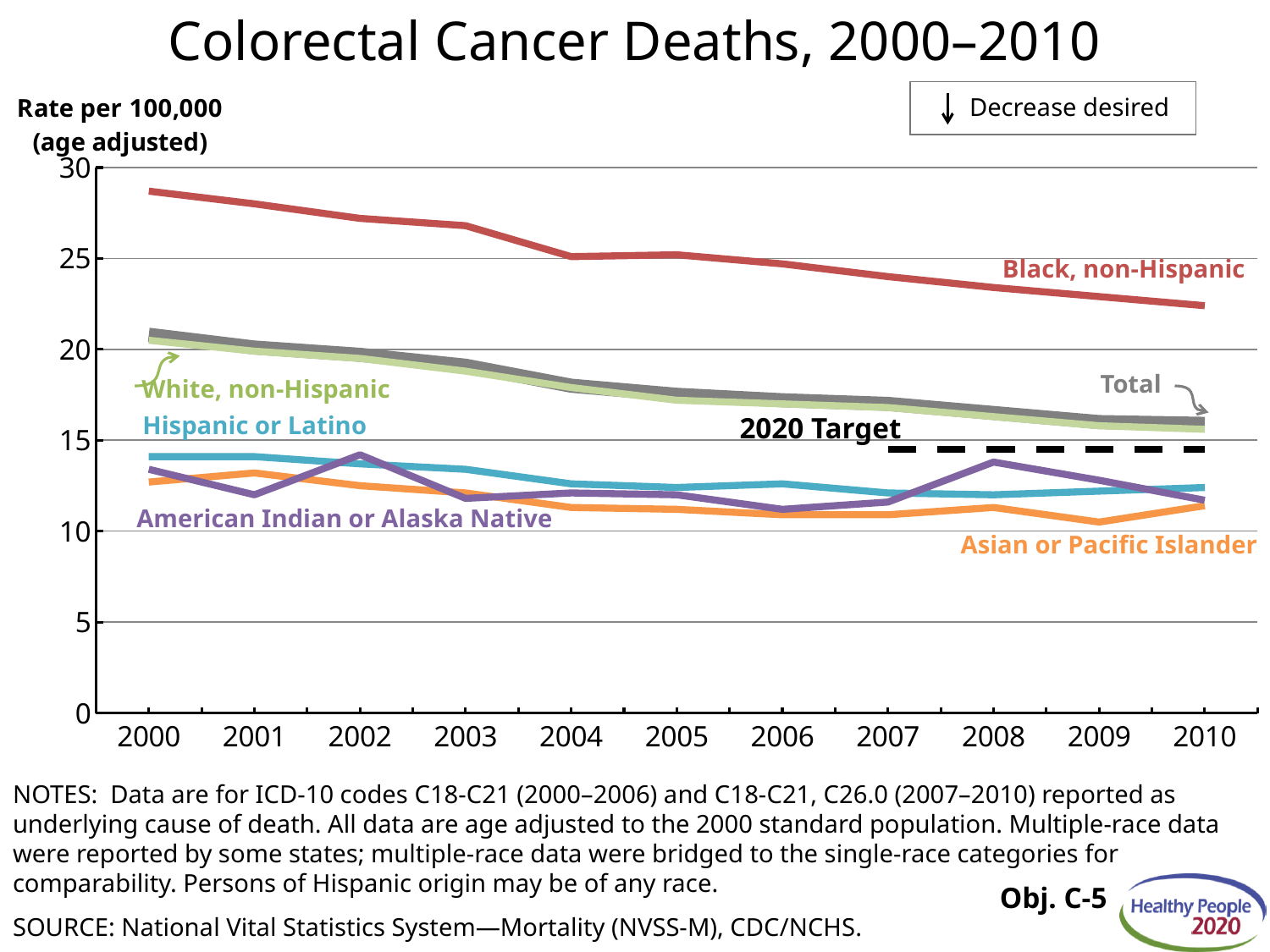
How many racial/ethnic groups, excluding Total, are plotted as lines? 5 In 2005, which group has the higher death rate: Black, non-Hispanic or White, non-Hispanic? Black, non-Hispanic Which group has the highest colorectal cancer death rate in 2010? Black, non-Hispanic How many years are shown along the x axis? 11 Does the death rate for Black, non-Hispanic rise or fall from 2000 to 2010? Fall What does the dashed black line on the chart represent? 2020 Target Is the 2000 death rate for Black, non-Hispanic greater or less than 25? greater Which group has the lowest colorectal cancer death rate in 2009? Asian or Pacific Islander What is the title of the chart? Colorectal Cancer Deaths, 2000–2010 What kind of chart is shown on the slide? Line chart Is the 2000 death rate for Hispanic or Latino greater or less than 15? less Is the 2010 death rate for Black, non-Hispanic greater or less than 25? less